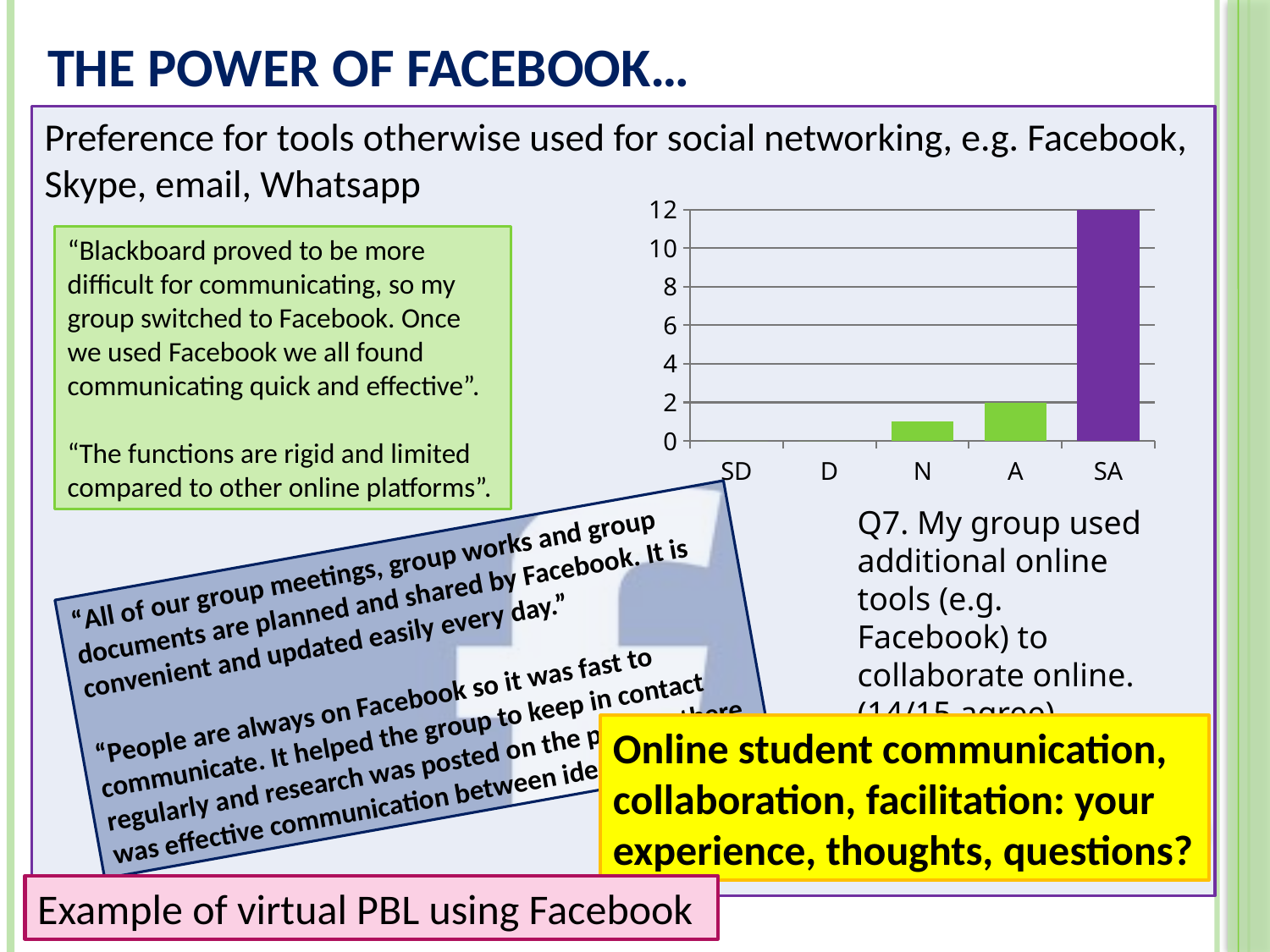
Which category has the highest value in the chart? SA Do the values rise or fall moving from SD to SA along the x axis? rise What is the difference between the values for SA and A? 10 Is the value for SA greater or less than 10? greater What kind of chart is shown on the slide? bar chart Is the value for N greater or less than 2? less What is the value for SA in the chart? 12 What is the highest value shown on the y axis of the chart? 12 How many categories are shown on the x axis of the chart? 5 What colour is the bar for SA? purple What is the value for A in the chart? 2 Which is larger, the value for A or the value for N? A